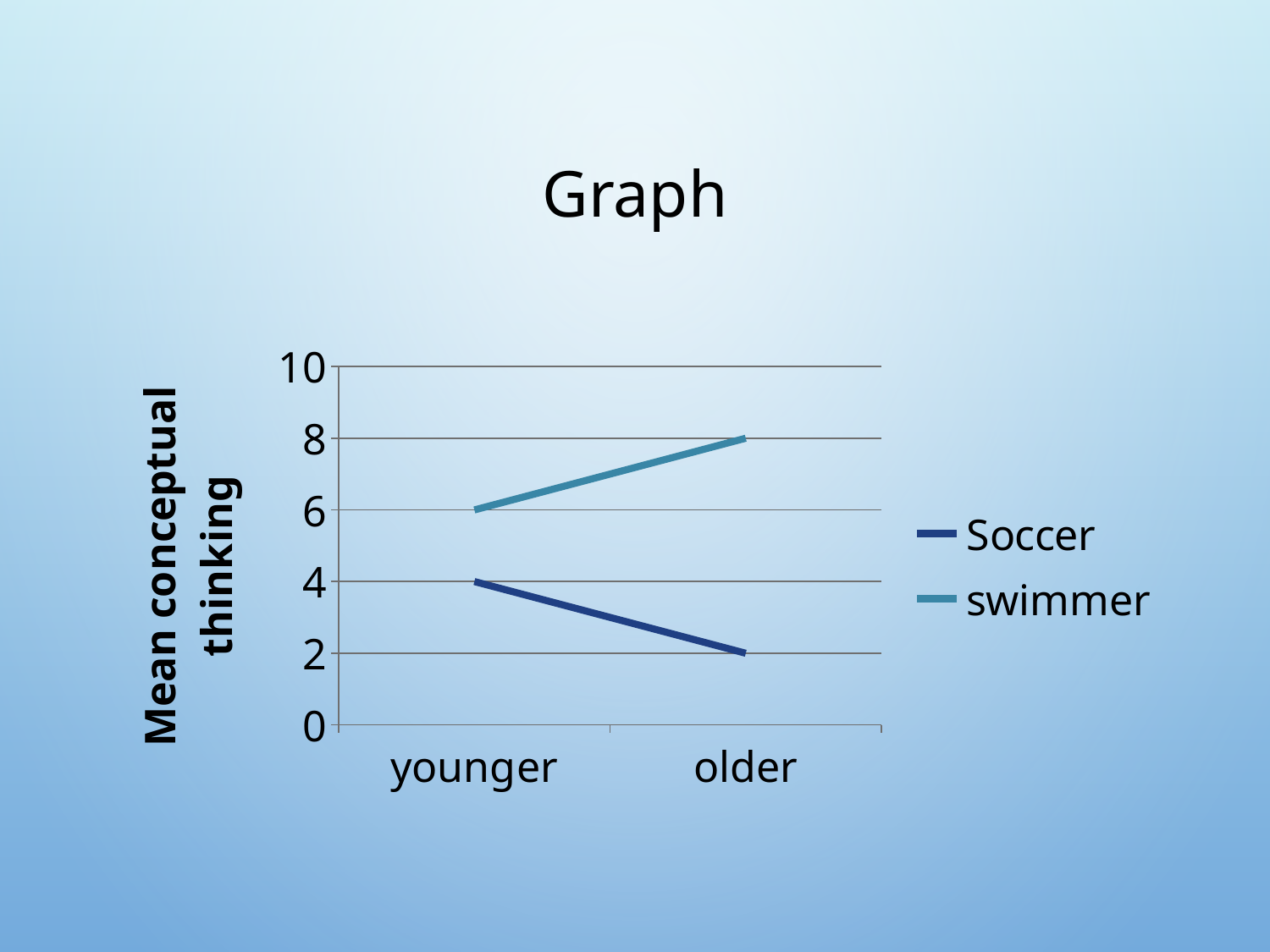
What is the difference between the swimmer value and the Soccer value at older? 6 Does the swimmer line rise or fall from younger to older? rise What is the label of the vertical axis? Mean conceptual thinking Which series has the higher value at younger, Soccer or swimmer? swimmer What is the value for Soccer at younger? 4 How many series does the legend list? 2 What is the value for swimmer at older? 8 Does the Soccer line rise or fall from younger to older? fall What kind of chart is shown on the slide? line chart What is the value for swimmer at younger? 6 What is the value for Soccer at older? 2 How many categories are shown on the x axis? 2